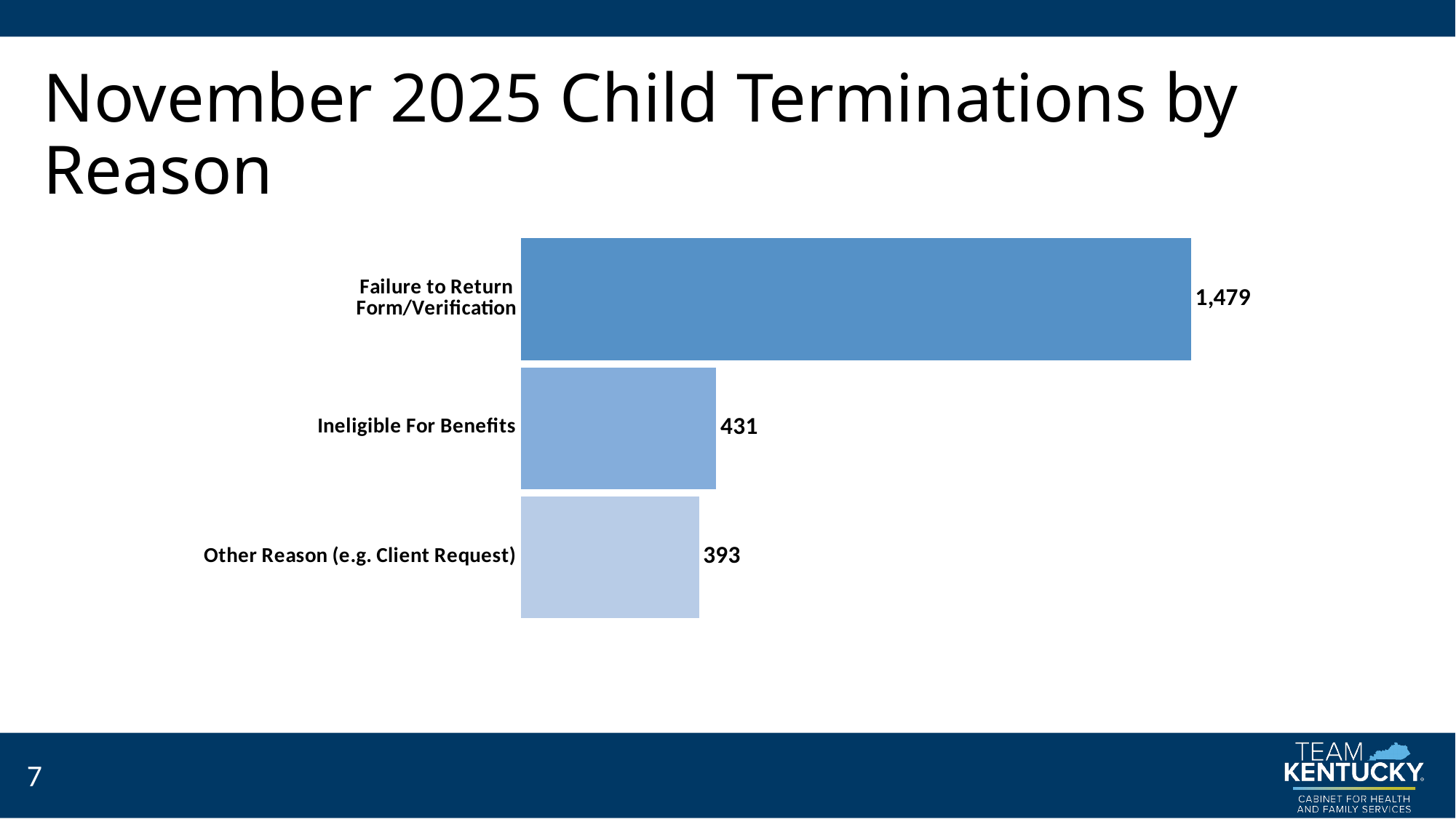
What is the title of the slide? November 2025 Child Terminations by Reason Which is larger, Ineligible For Benefits or Other Reason (e.g. Client Request)? Ineligible For Benefits What is the difference between Ineligible For Benefits and Other Reason (e.g. Client Request)? 38 What is the value for Ineligible For Benefits? 431 What is the value for Other Reason (e.g. Client Request)? 393 Which reason has the lowest number of child terminations? Other Reason (e.g. Client Request) What is the value for Failure to Return Form/Verification? 1,479 How many reason categories are shown in the chart? 3 What kind of chart is shown on the slide? Bar chart What is the total of the three values shown in the chart? 2,303 What is the difference between Failure to Return Form/Verification and Ineligible For Benefits? 1,048 Which reason has the highest number of child terminations? Failure to Return Form/Verification